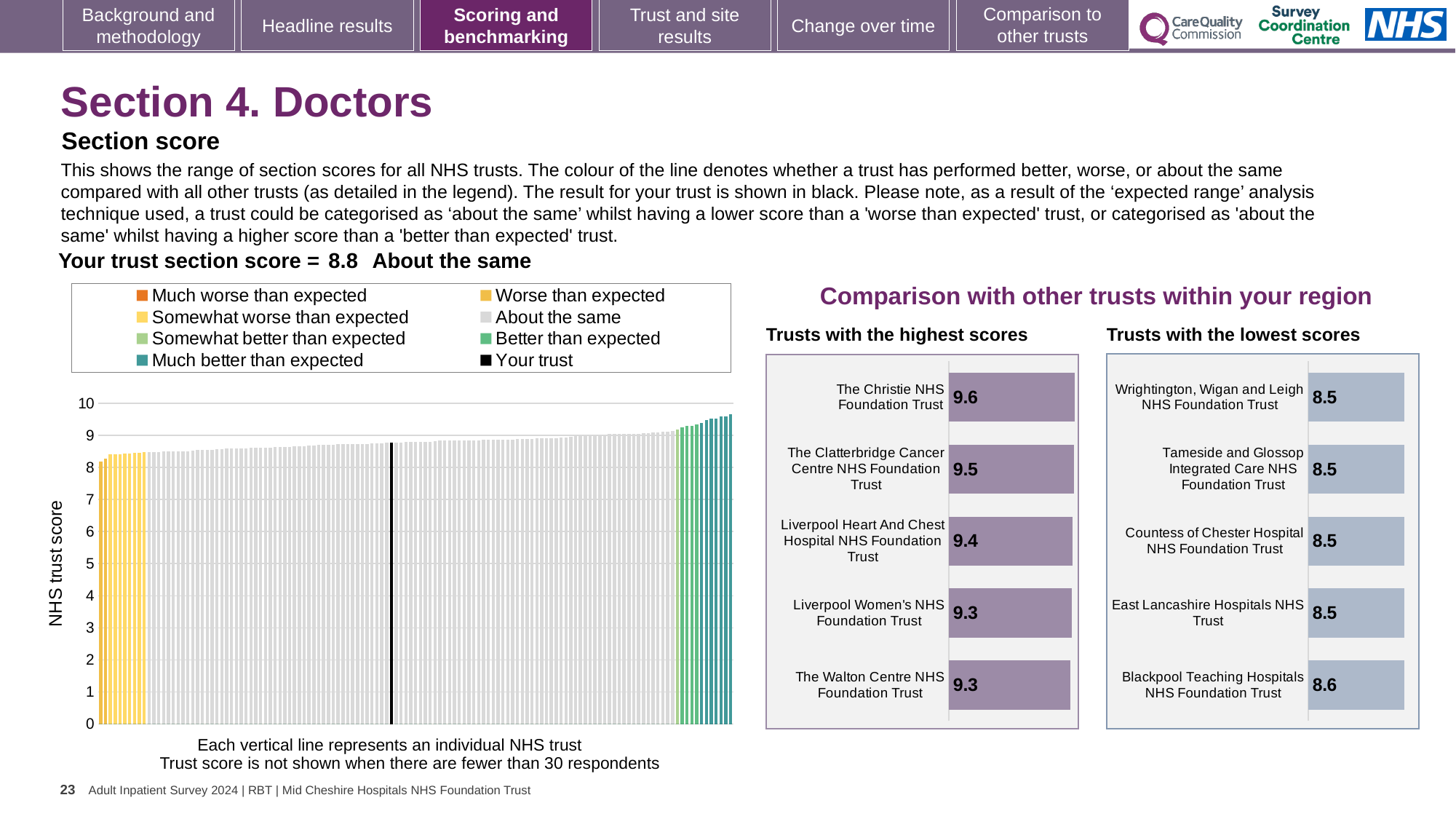
In the 'Trusts with the highest scores' chart, which has the higher score: The Clatterbridge Cancer Centre NHS Foundation Trust or Liverpool Heart And Chest Hospital NHS Foundation Trust? The Clatterbridge Cancer Centre NHS Foundation Trust In the 'Trusts with the lowest scores' chart, what is the score for Blackpool Teaching Hospitals NHS Foundation Trust? 8.6 In the 'Trusts with the highest scores' chart, how many trusts are shown? 5 What is the section score for your trust shown on the slide? 8.8 On the large chart on the left, what is the label of the vertical axis? NHS trust score In the 'Trusts with the highest scores' chart, which trust has the highest score? The Christie NHS Foundation Trust In the 'Trusts with the highest scores' chart, what is the score for The Christie NHS Foundation Trust? 9.6 In the 'Trusts with the highest scores' chart, what is the difference between the scores of The Christie NHS Foundation Trust and The Walton Centre NHS Foundation Trust? 0.3 How many entries does the legend above the large chart on the left list? 8 What kind of chart is the large chart on the left showing NHS trust scores? bar chart In the 'Trusts with the lowest scores' chart, what is the difference between the scores of Blackpool Teaching Hospitals NHS Foundation Trust and Wrightington, Wigan and Leigh NHS Foundation Trust? 0.1 On the large chart on the left, is the value of the black bar for your trust greater or less than 8? greater